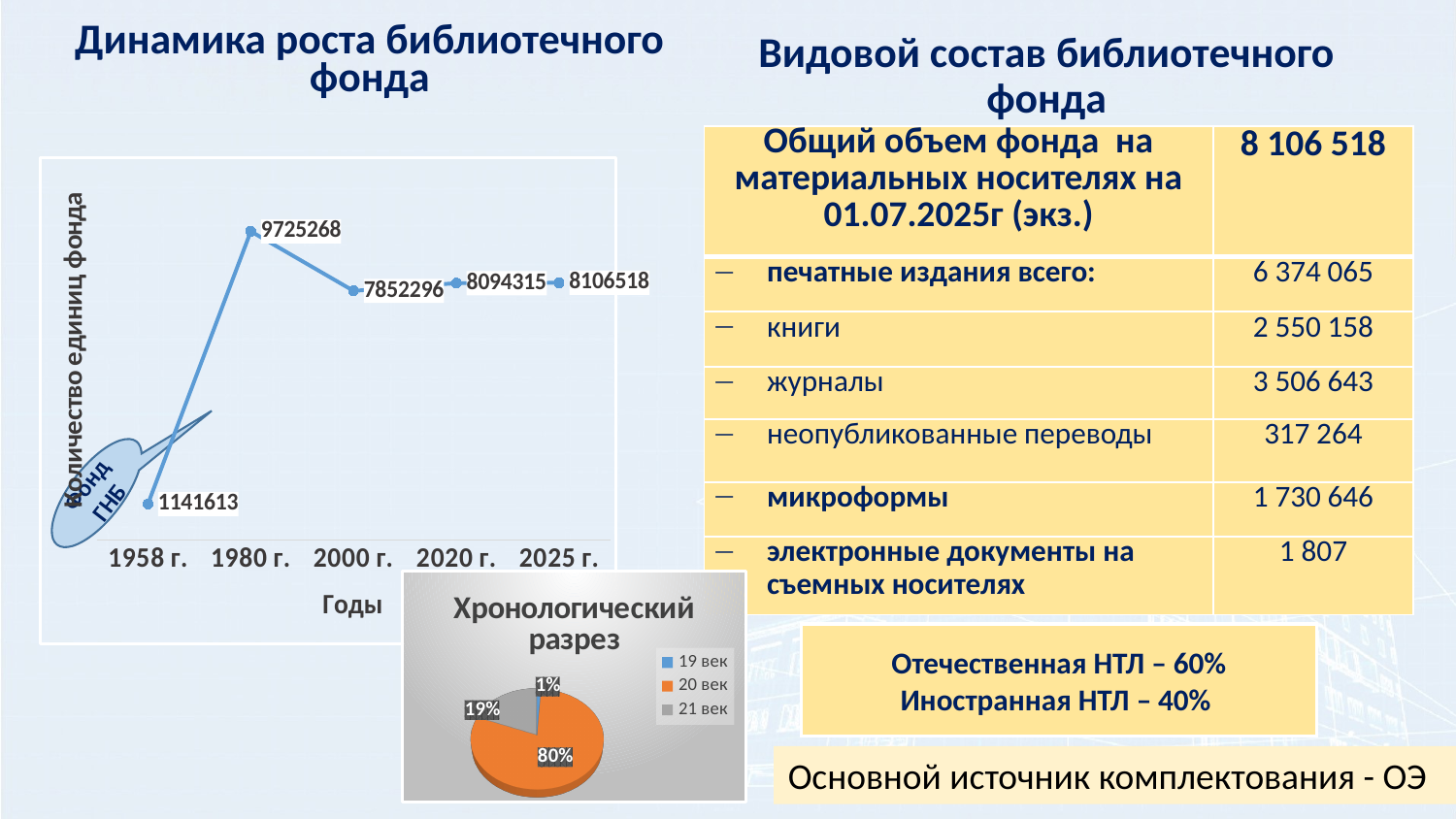
What type of chart is 'Хронологический разрез'? pie chart How many entries does the legend of the pie chart 'Хронологический разрез' list? 3 In the line chart 'Динамика роста библиотечного фонда', what is the difference between the values for 2025 г. and 2020 г.? 12203 In the line chart 'Динамика роста библиотечного фонда', what is the value for 1958 г.? 1141613 In the pie chart 'Хронологический разрез', which category has the smallest share? 19 век In the pie chart 'Хронологический разрез', what share does 20 век have? 80% In the line chart 'Динамика роста библиотечного фонда', which year has the highest value? 1980 г. In the line chart 'Динамика роста библиотечного фонда', which is larger: the value for 1980 г. or the value for 2000 г.? 1980 г. How many data points are plotted in the line chart 'Динамика роста библиотечного фонда'? 5 In the line chart 'Динамика роста библиотечного фонда', which year has the lowest value? 1958 г. In the line chart 'Динамика роста библиотечного фонда', does the value rise or fall between 1958 г. and 1980 г.? rise In the line chart 'Динамика роста библиотечного фонда', what is the value for 2025 г.? 8106518